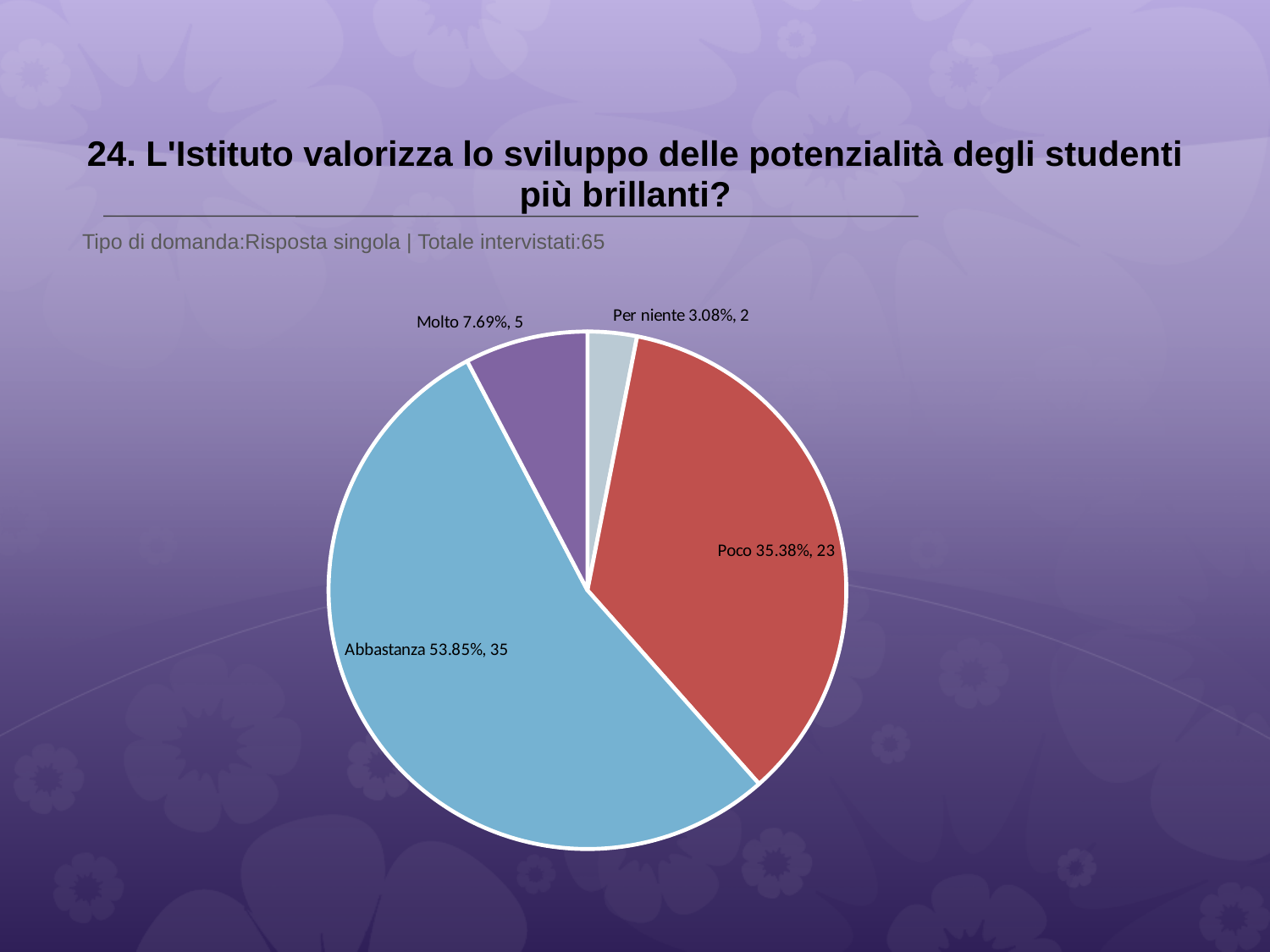
Which slice is larger, Poco or Molto? Poco What is the total number of respondents shown in the subtitle? 65 Which response has the smallest slice of the pie? Per niente What colour is the Poco slice? red How many slices does the pie chart have? 4 What is the difference in respondent count between Abbastanza and Poco? 12 Which response has the largest slice of the pie? Abbastanza What percentage share does the Per niente slice have? 3.08% What kind of chart is shown on the slide? pie chart What percentage share does the Abbastanza slice have? 53.85% How many respondents answered Molto? 5 How many respondents answered Poco? 23